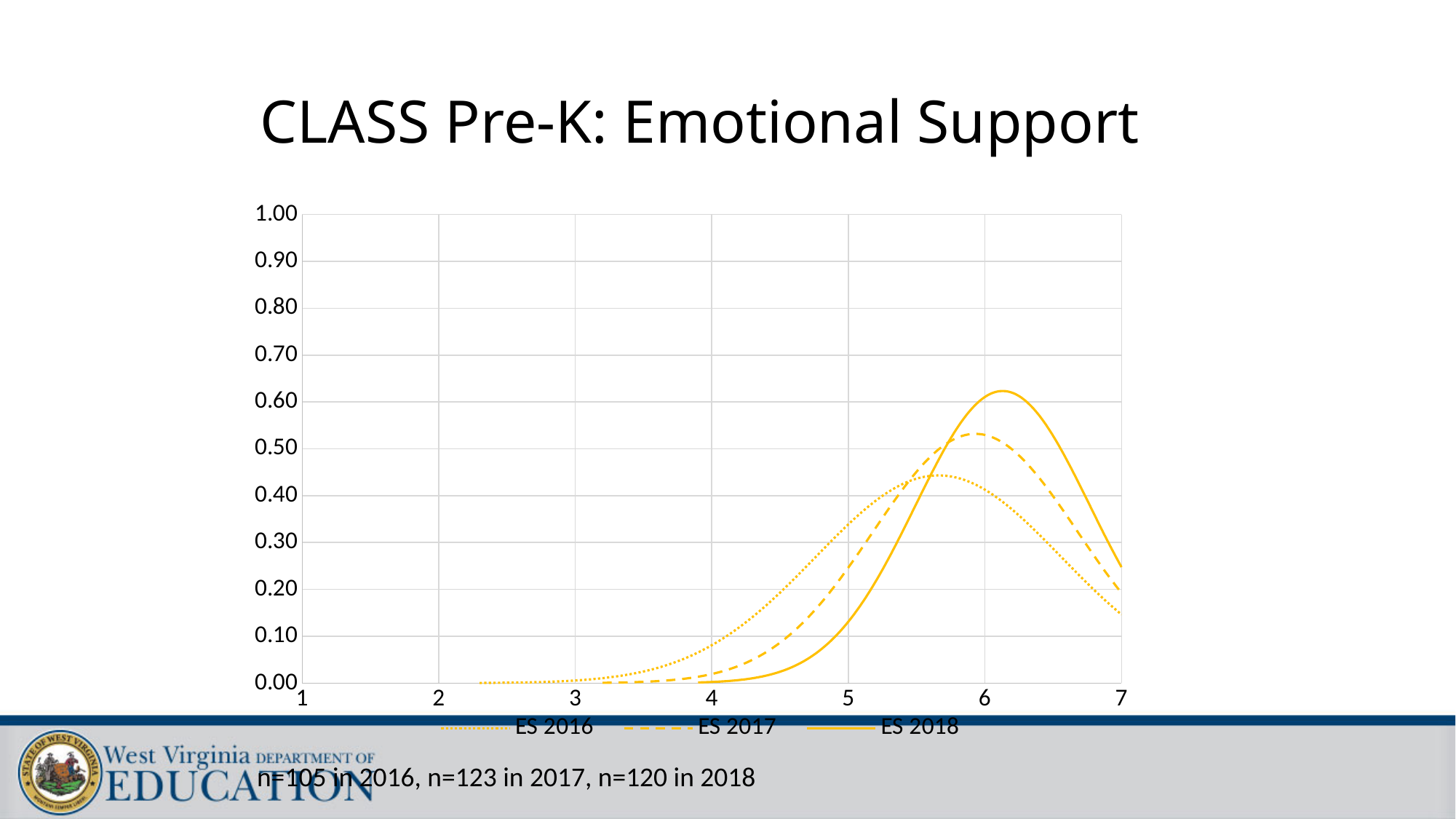
Is the value of the ES 2016 curve at x = 4 greater or less than 0.10? less Is the peak value of the ES 2016 curve greater or less than 0.50? less What are the series names listed in the legend? ES 2016, ES 2017, ES 2018 Which series reaches the highest peak value? ES 2018 What kind of chart is shown on the slide? Line chart Is the value of the ES 2018 curve at x = 7 greater or less than 0.20? greater How many series does the legend list? 3 How many labelled tick values are shown on the x axis? 7 Which series has the lowest peak value? ES 2016 What is the title of the chart? CLASS Pre-K: Emotional Support Which curve has the larger peak, ES 2017 or ES 2016? ES 2017